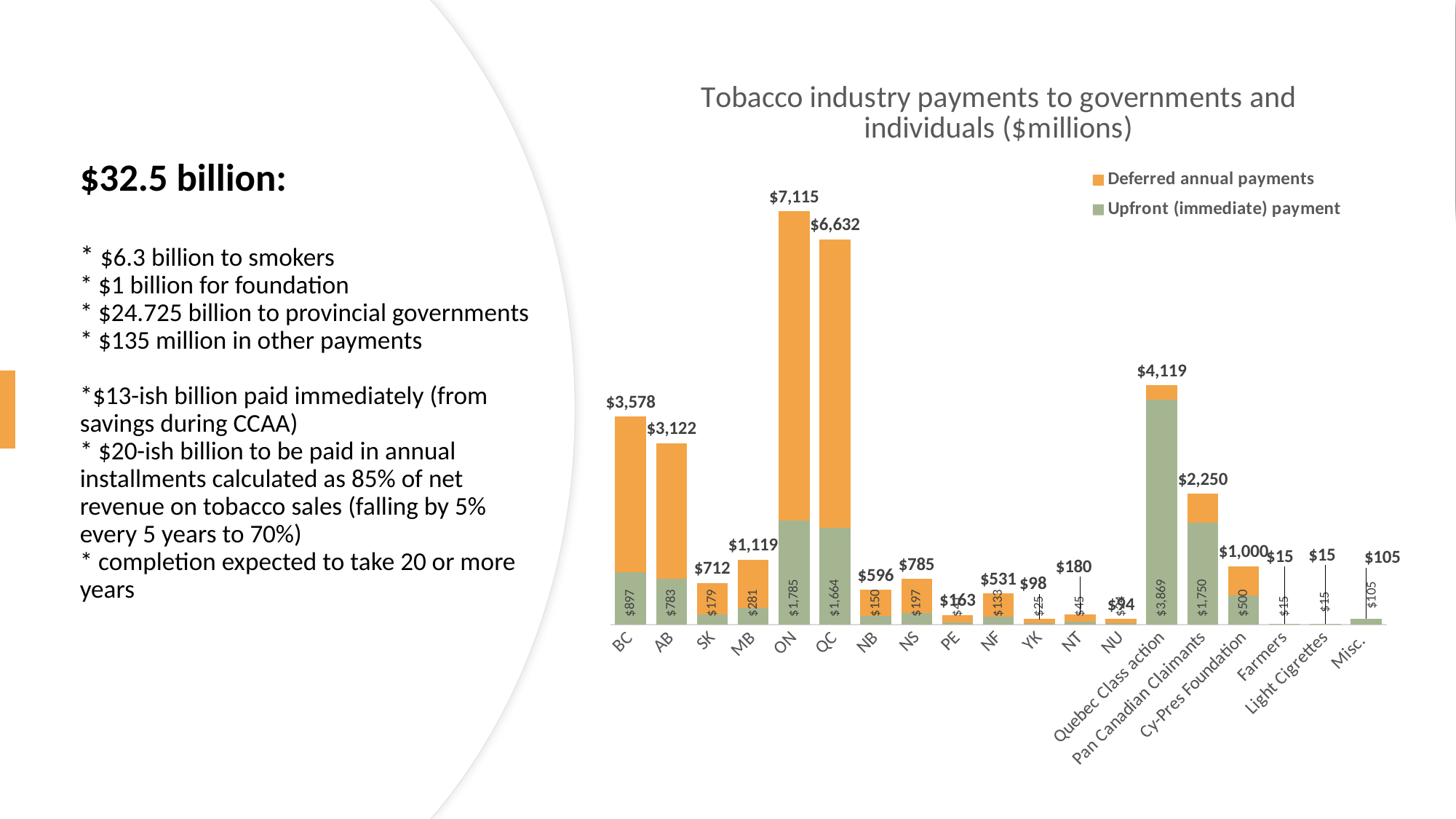
What is the upfront (immediate) payment for BC? $897 How many series does the legend list? 2 What is the total payment labelled for QC? $6,632 What is the difference between the total payments for ON and QC? $483 How many categories are shown along the x axis? 19 Which category has the highest total payment? ON Which has the larger total payment, BC or AB? BC Which colour represents Deferred annual payments in the legend? orange What is the upfront (immediate) payment for Quebec Class action? $3,869 What is the deferred annual payment amount for ON, given its total of $7,115 and upfront payment of $1,785? $5,330 What kind of chart is shown on the slide? bar chart What is the total payment labelled for Pan Canadian Claimants? $2,250